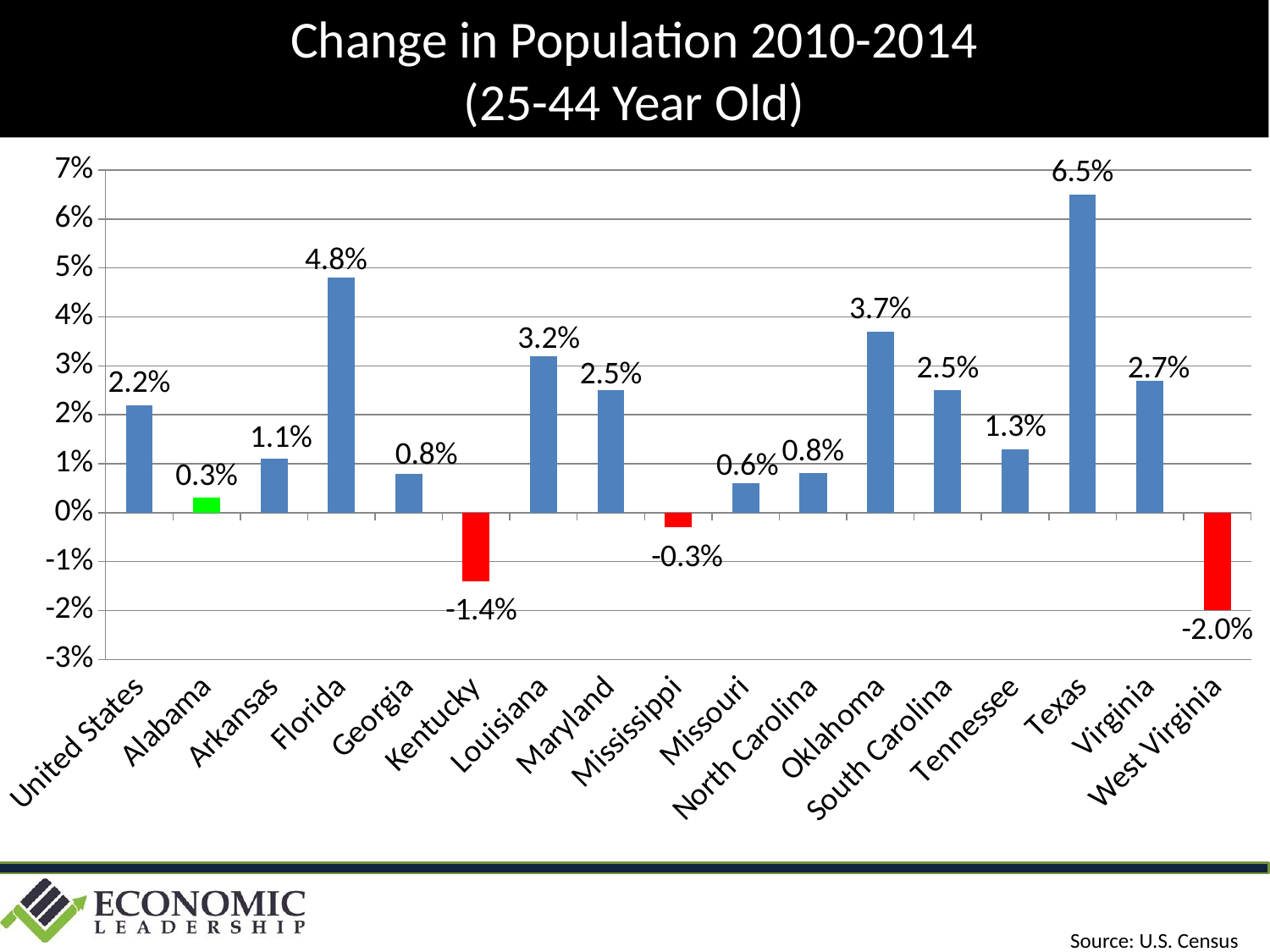
How many categories are shown on the x axis? 17 What kind of chart is shown on the slide? Bar chart Which is larger, the value for Louisiana or the value for Virginia? Louisiana What is the difference between the values for Texas and the United States? 4.3% What is the change in population for Texas? 6.5% Which category has the highest change in population? Texas What is the difference between the values for Florida and Oklahoma? 1.1% Which category has the lowest change in population? West Virginia Is the value for Oklahoma greater or less than 3%? greater What is the title of the chart? Change in Population 2010-2014 (25-44 Year Old) What is the change in population for Kentucky? -1.4% What is the change in population for North Carolina? 0.8%